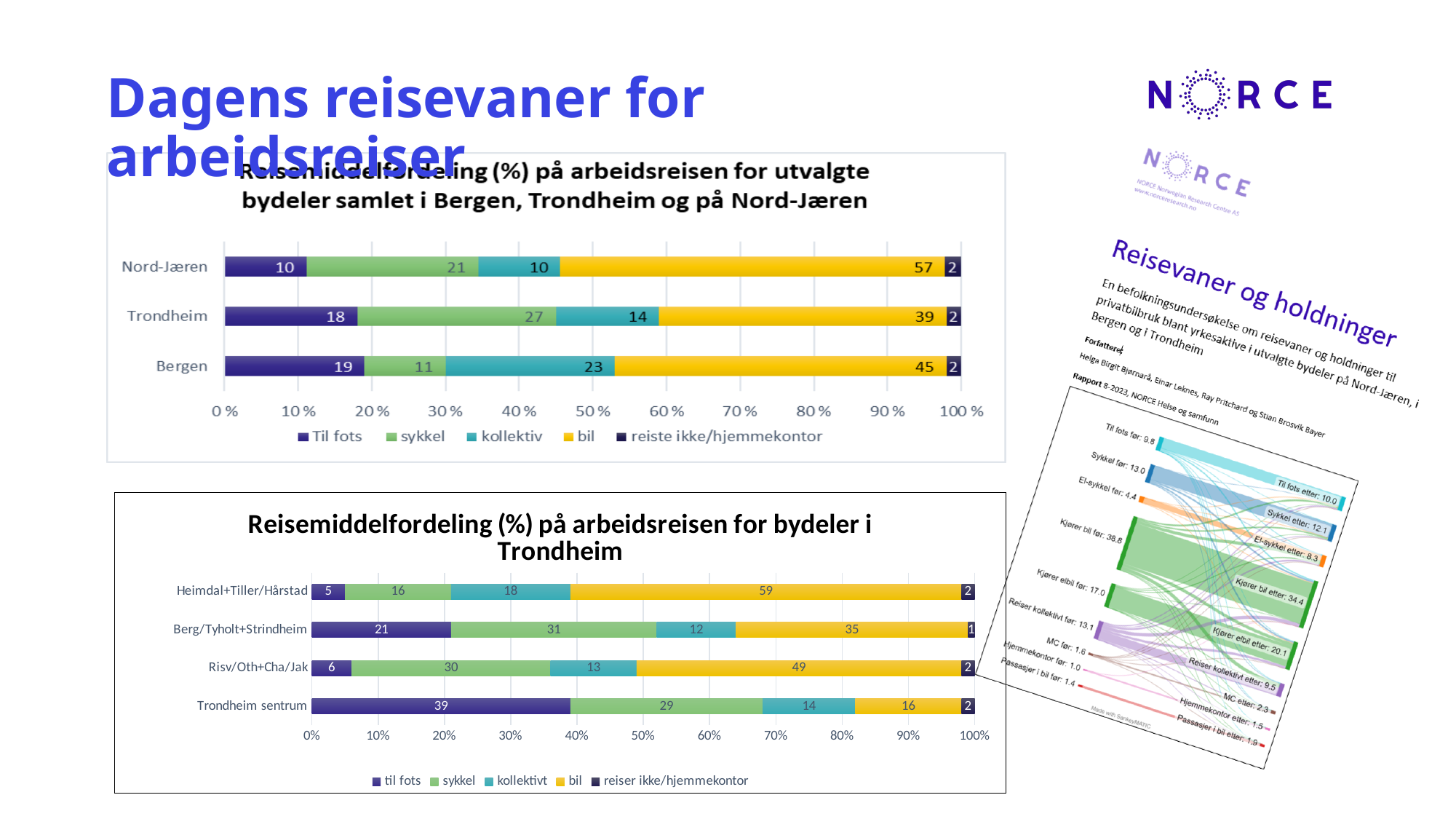
In the top chart (utvalgte bydeler samlet i Bergen, Trondheim og på Nord-Jæren), what is the difference between the bil values for Nord-Jæren and Trondheim? 18 In the top chart (utvalgte bydeler samlet i Bergen, Trondheim og på Nord-Jæren), how many series does the legend list? 5 In the top chart (utvalgte bydeler samlet i Bergen, Trondheim og på Nord-Jæren), what is the value for kollektiv for Bergen? 23 In the bottom chart (bydeler i Trondheim), how many bydeler (categories) are shown? 4 In the bottom chart (bydeler i Trondheim), which bydel has the lowest value for bil? Trondheim sentrum In the bottom chart (bydeler i Trondheim), what is the value for til fots for Trondheim sentrum? 39 In the top chart (utvalgte bydeler samlet i Bergen, Trondheim og på Nord-Jæren), what is the value for bil for Nord-Jæren? 57 In the top chart (utvalgte bydeler samlet i Bergen, Trondheim og på Nord-Jæren), what kind of chart is shown? Stacked bar chart In the bottom chart (bydeler i Trondheim), which is larger: the sykkel value for Berg/Tyholt+Strindheim or for Risv/Oth/Cha/Jak? Berg/Tyholt+Strindheim In the bottom chart (bydeler i Trondheim), what is the value for bil for Heimdal+Tiller/Hårstad? 59 In the top chart (utvalgte bydeler samlet i Bergen, Trondheim og på Nord-Jæren), which city has the highest value for sykkel? Trondheim In the bottom chart (bydeler i Trondheim), what is the difference between the til fots values for Trondheim sentrum and Heimdal+Tiller/Hårstad? 34